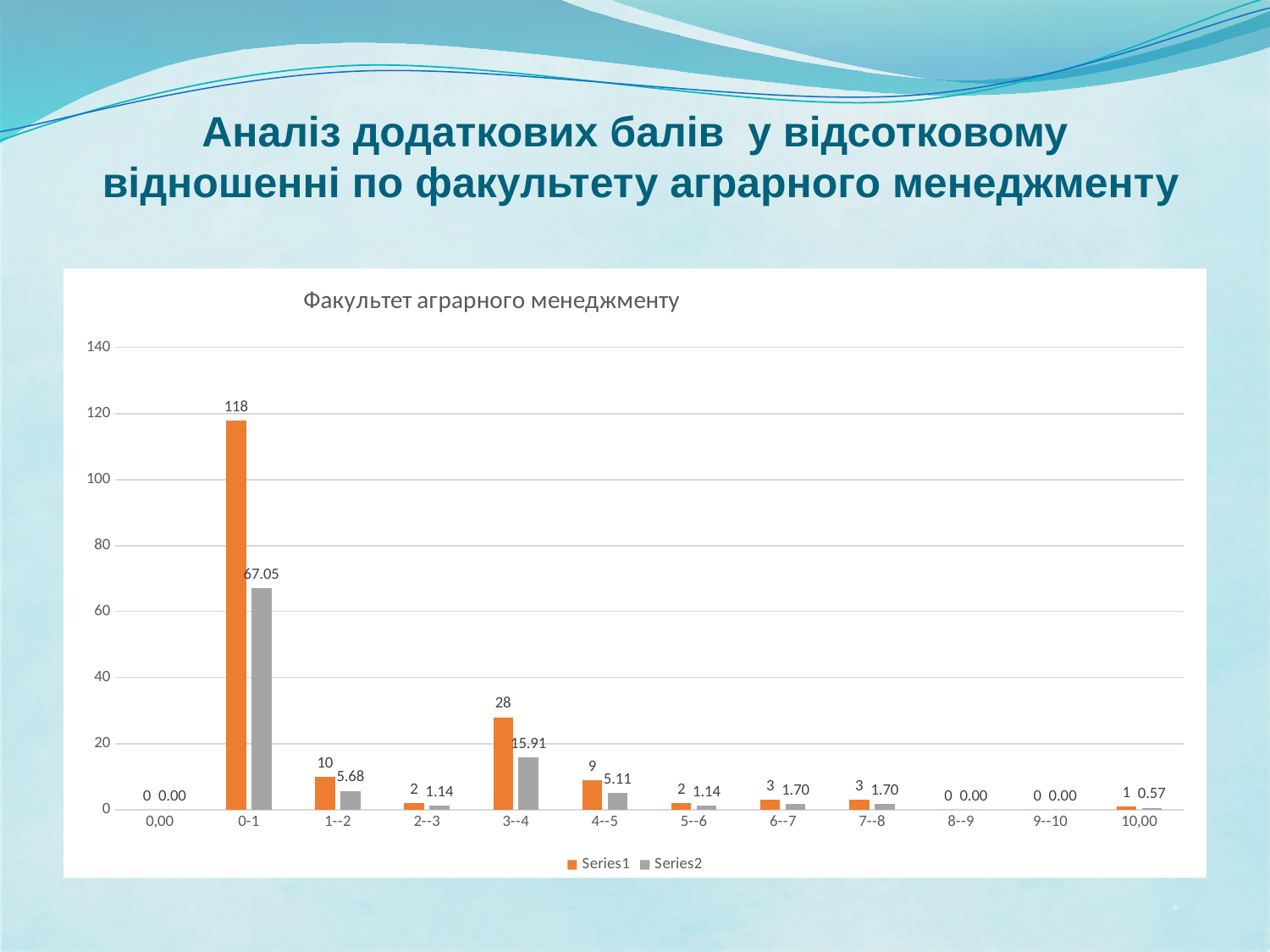
What is the Series1 value for the 10,00 category? 1 Is the Series1 value for 0-1 greater or less than 100? greater How many categories are shown on the x axis? 12 What kind of chart is shown? bar chart How many series does the legend list? 2 What is the difference between the Series1 values for 0-1 and 3--4? 90 What is the title of the chart? Факультет аграрного менеджменту What is the Series2 value for the 0-1 category? 67.05 Which is larger, the Series1 value for 1--2 or for 4--5? 1--2 Which category has the highest Series1 value? 0-1 What is the Series2 value for the 3--4 category? 15.91 What is the Series1 value for the 0-1 category? 118